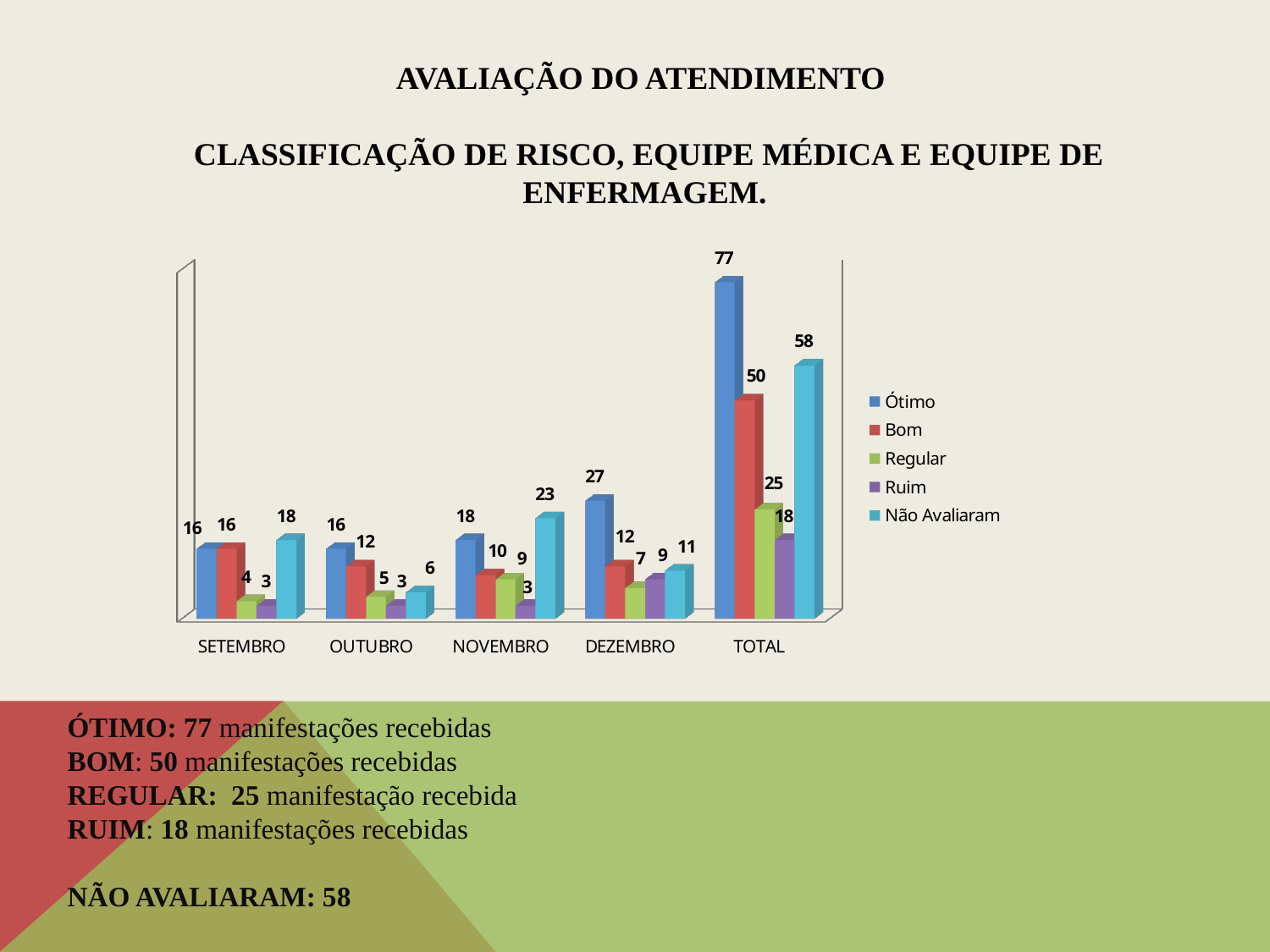
What is the value for Não Avaliaram in NOVEMBRO? 23 Which category has the highest value for Ótimo? TOTAL Which month (excluding TOTAL) has the lowest value for Não Avaliaram? OUTUBRO Which legend entry is shown in red? Bom Does the value for Ótimo rise or fall from SETEMBRO to DEZEMBRO? rise Which is larger in NOVEMBRO, Ótimo or Não Avaliaram? Não Avaliaram How many categories are shown on the x axis? 5 How many series does the legend list? 5 What is the value for Ótimo in DEZEMBRO? 27 What is the value for Regular in OUTUBRO? 5 What is the difference between Ótimo and Bom in the TOTAL category? 27 What type of chart is shown on the slide? bar chart